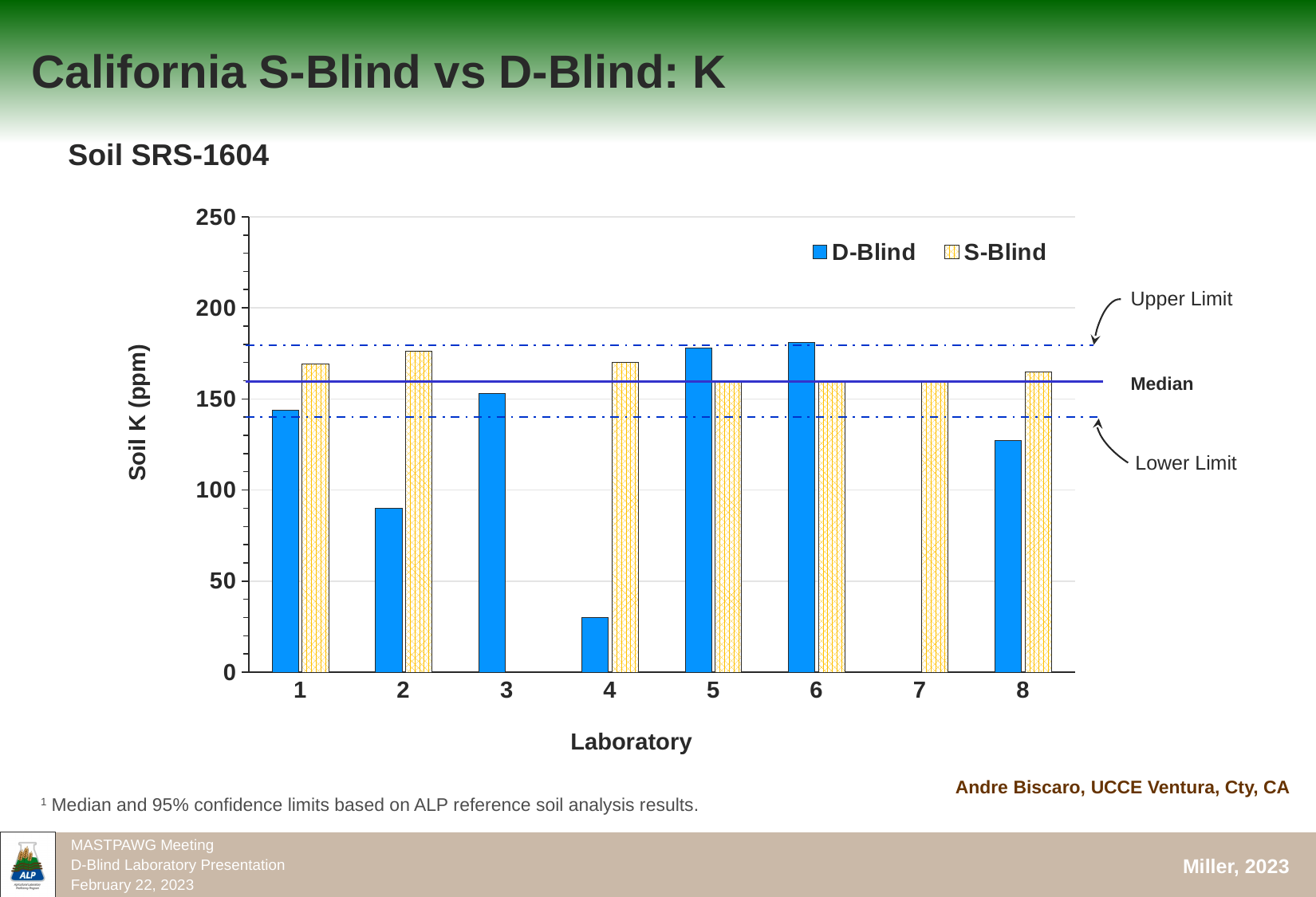
Is the D-Blind value for laboratory 4 greater or less than 50? less How many laboratories are shown on the x axis? 8 Which laboratory has the lowest D-Blind value? 4 For laboratory 5, which is larger, the D-Blind or the S-Blind value? D-Blind For laboratory 1, which is larger, the D-Blind or the S-Blind value? S-Blind What kind of chart is shown on the slide? Bar chart What is the title of the y axis? Soil K (ppm) Is the D-Blind value for laboratory 2 greater or less than 100? less Is the S-Blind value for laboratory 2 greater or less than 150? greater What are the two series named in the legend? D-Blind and S-Blind How many series does the legend list? 2